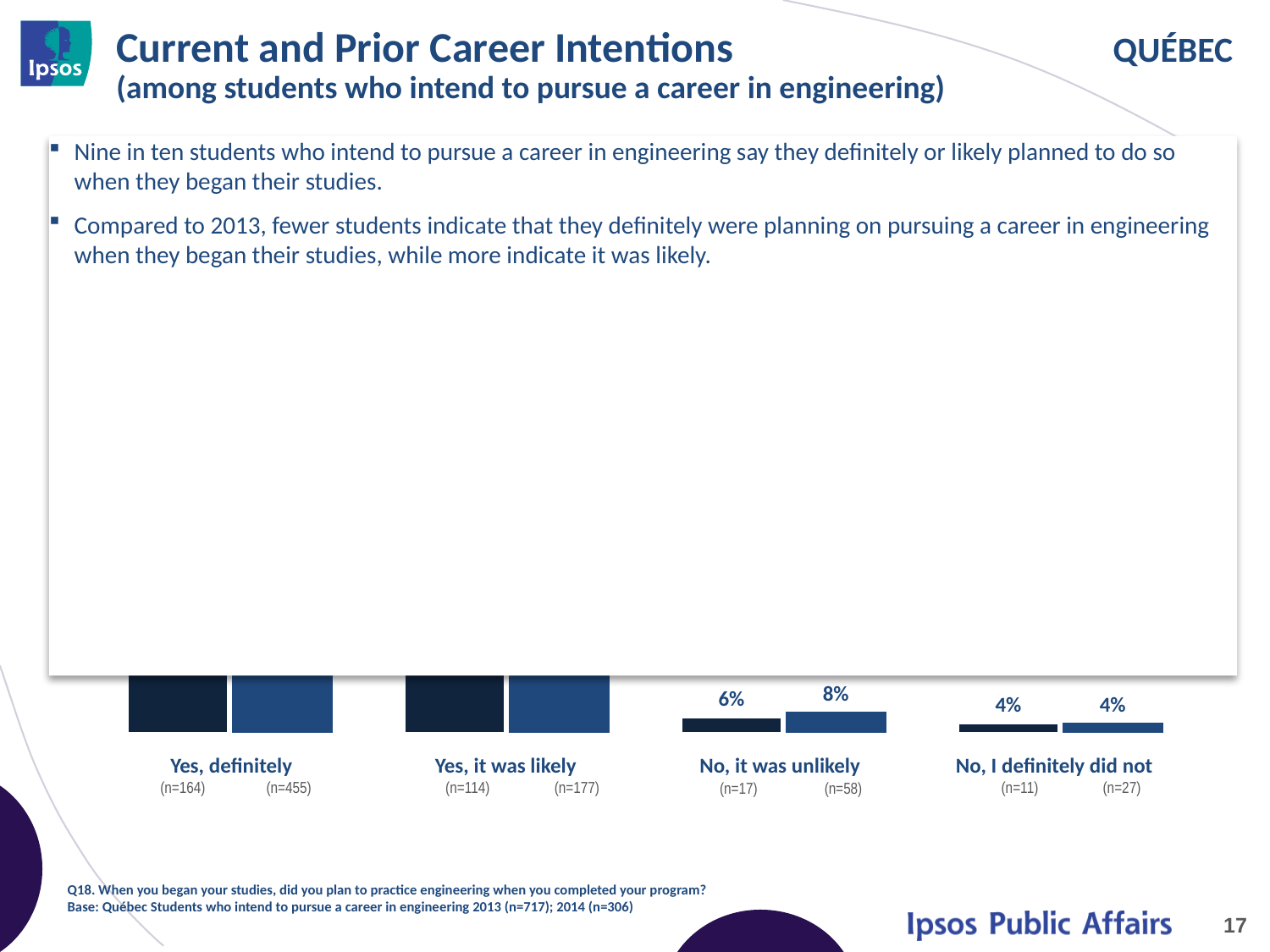
What is the difference between the two bars for "No, it was unlikely"? 2 percentage points What is the label of the first (leftmost) category on the chart? Yes, definitely What is the value of the lighter blue (right) bar for "No, it was unlikely"? 8% What kind of chart is shown on the slide? Bar chart For the lighter blue (right) bars, which is lower: "No, it was unlikely" or "No, I definitely did not"? No, I definitely did not For the dark navy (left) bars, which is larger: "No, it was unlikely" or "No, I definitely did not"? No, it was unlikely How many response categories are shown along the bottom of the chart? 4 What is the value of the lighter blue (right) bar for "No, I definitely did not"? 4% What sample size is printed under the dark navy (left) bar for "Yes, definitely"? n=164 What is the value of the dark navy (left) bar for "No, it was unlikely"? 6% For "No, it was unlikely", which bar is larger, the dark navy (left) bar or the lighter blue (right) bar? The lighter blue (right) bar What is the value of the dark navy (left) bar for "No, I definitely did not"? 4%